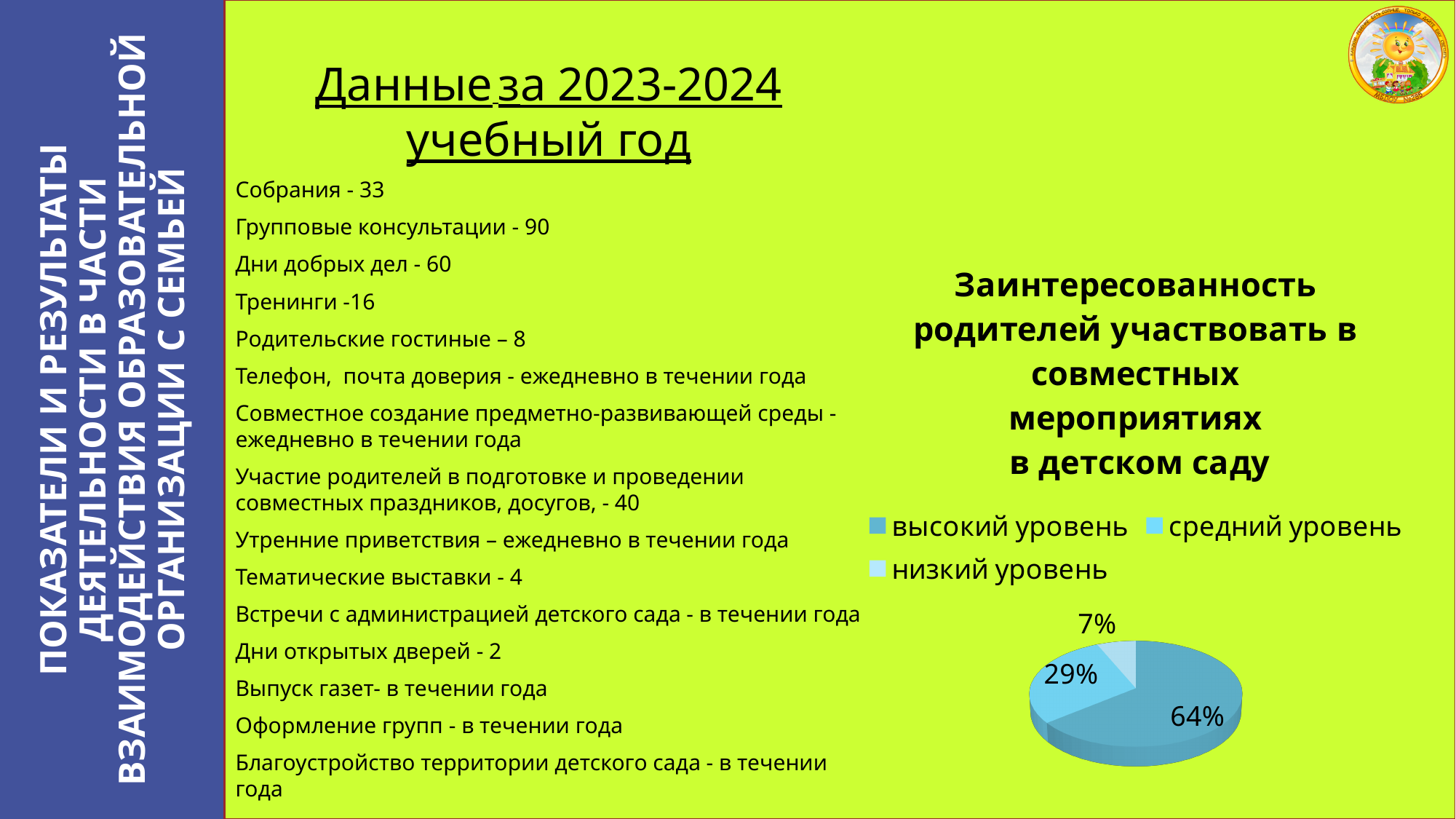
Which category has the smallest slice in the pie chart? низкий уровень What share of the pie chart is labelled "низкий уровень"? 7% What is the difference in percentage points between the "высокий уровень" and "средний уровень" slices? 35 Which slice is larger: "средний уровень" or "низкий уровень"? средний уровень How many slices does the pie chart have? 3 What kind of chart is shown on the slide? pie chart What is the title of the pie chart? Заинтересованность родителей участвовать в совместных мероприятиях в детском саду What share of the pie chart is labelled "высокий уровень"? 64% What share of the pie chart is labelled "средний уровень"? 29% Which category has the largest slice in the pie chart? высокий уровень What is the difference in percentage points between the "средний уровень" and "низкий уровень" slices? 22 How many entries does the chart legend list? 3